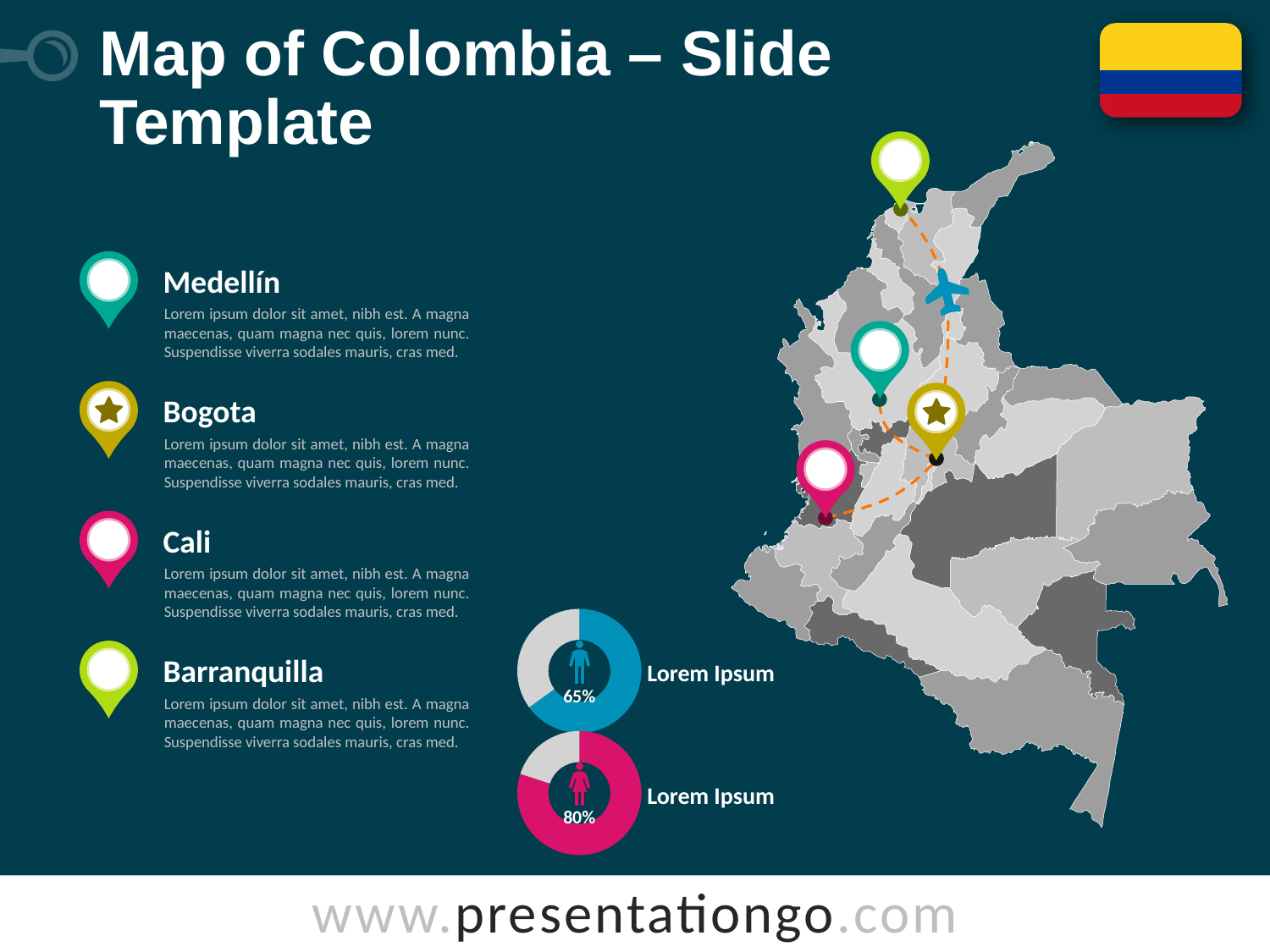
What is the difference between the percentage in the lower donut chart and the percentage in the upper donut chart? 15 percentage points What percentage is shown in the lower donut chart with the female figure? 80% What percentage is shown in the upper donut chart with the male figure? 65% What kind of chart is used to display the 65% and 80% values? donut (pie) chart What share of the lower donut chart is not filled by the 80% segment? 20% What colour is the filled segment of the upper donut chart? blue Which of the two donut charts shows the larger percentage, the upper (blue) one or the lower (pink) one? the lower (pink) one How many donut charts are shown on the slide? 2 Is the value in the upper donut chart greater or less than 50%? greater What label text appears to the right of each donut chart? Lorem Ipsum What share of the upper donut chart is not filled by the 65% segment? 35%